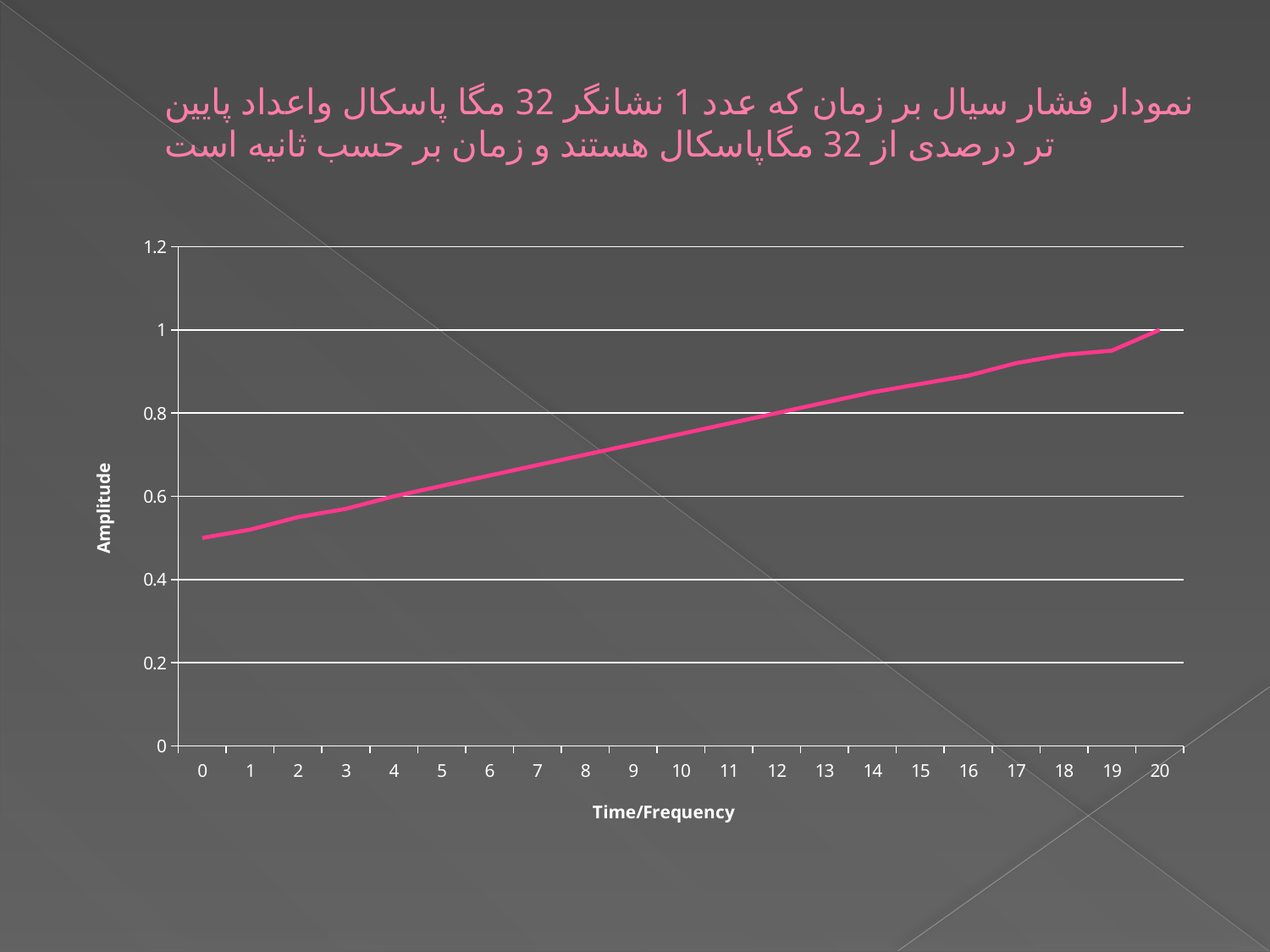
Which has the larger Amplitude, Time/Frequency 5 or Time/Frequency 15? 15 Is the Amplitude at Time/Frequency 8 greater or less than 0.6? greater What is the title of the vertical axis? Amplitude What kind of chart is shown on the slide? line chart At which Time/Frequency value is the Amplitude lowest? 0 Is the Amplitude at Time/Frequency 16 greater or less than 0.8? greater Is the Amplitude at Time/Frequency 0 greater or less than 0.4? greater What is the Amplitude value at Time/Frequency 20? 1 At which Time/Frequency value is the Amplitude highest? 20 How many Time/Frequency points are plotted on the x axis? 21 Does the Amplitude rise or fall as Time/Frequency increases from 0 to 20? rise